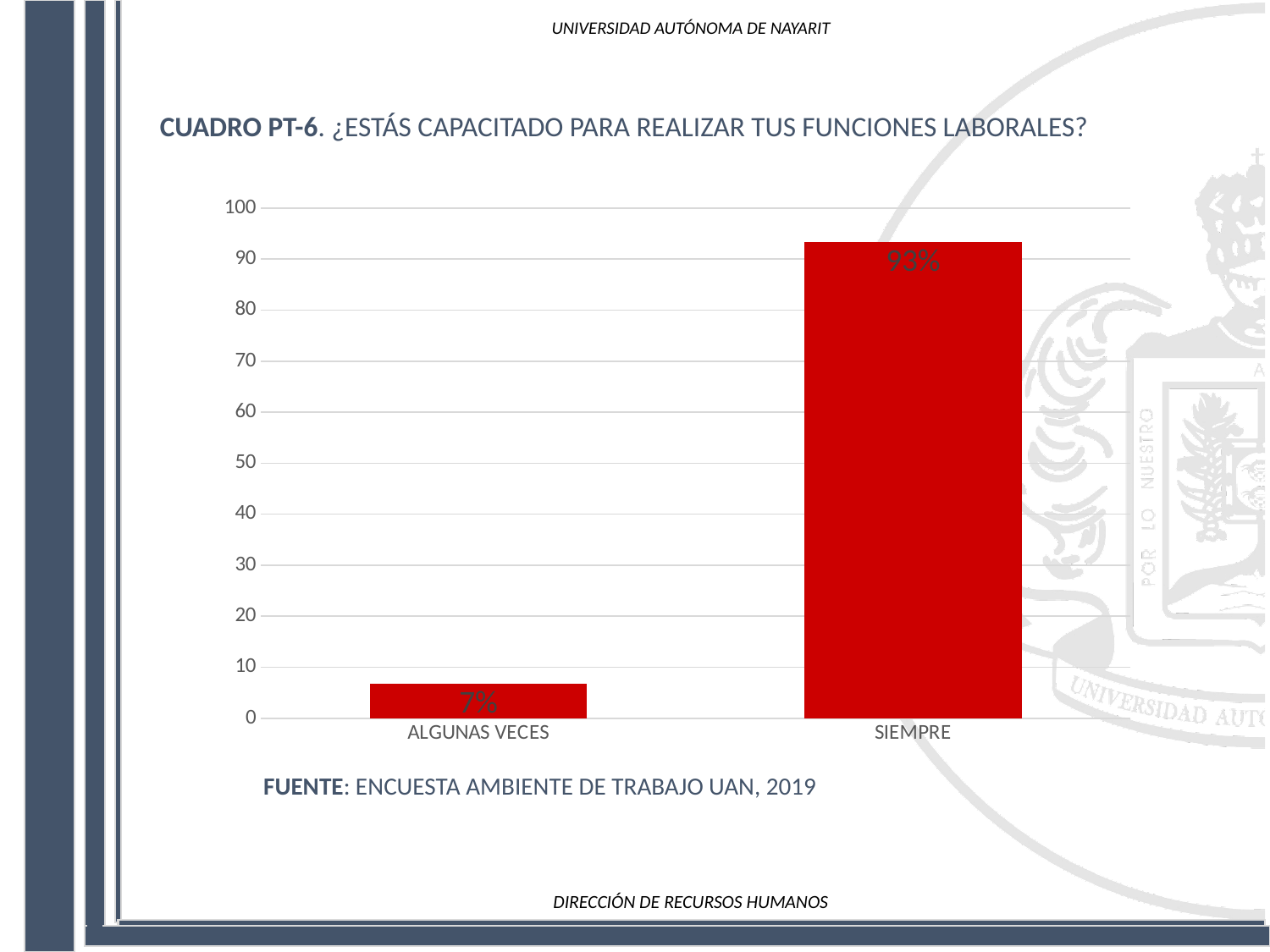
What is the maximum value shown on the vertical axis? 100 Is the value for SIEMPRE greater or less than 90? greater Which is larger, the value for ALGUNAS VECES or the value for SIEMPRE? SIEMPRE What is the value for SIEMPRE? 93% What is the value for ALGUNAS VECES? 7% Is the value for ALGUNAS VECES greater or less than 10? less Which category has the highest value? SIEMPRE What source is cited below the chart? ENCUESTA AMBIENTE DE TRABAJO UAN, 2019 How many categories are shown on the x axis? 2 Which category has the lowest value? ALGUNAS VECES What kind of chart is shown on the slide? Bar chart What is the difference between the values for SIEMPRE and ALGUNAS VECES? 86%